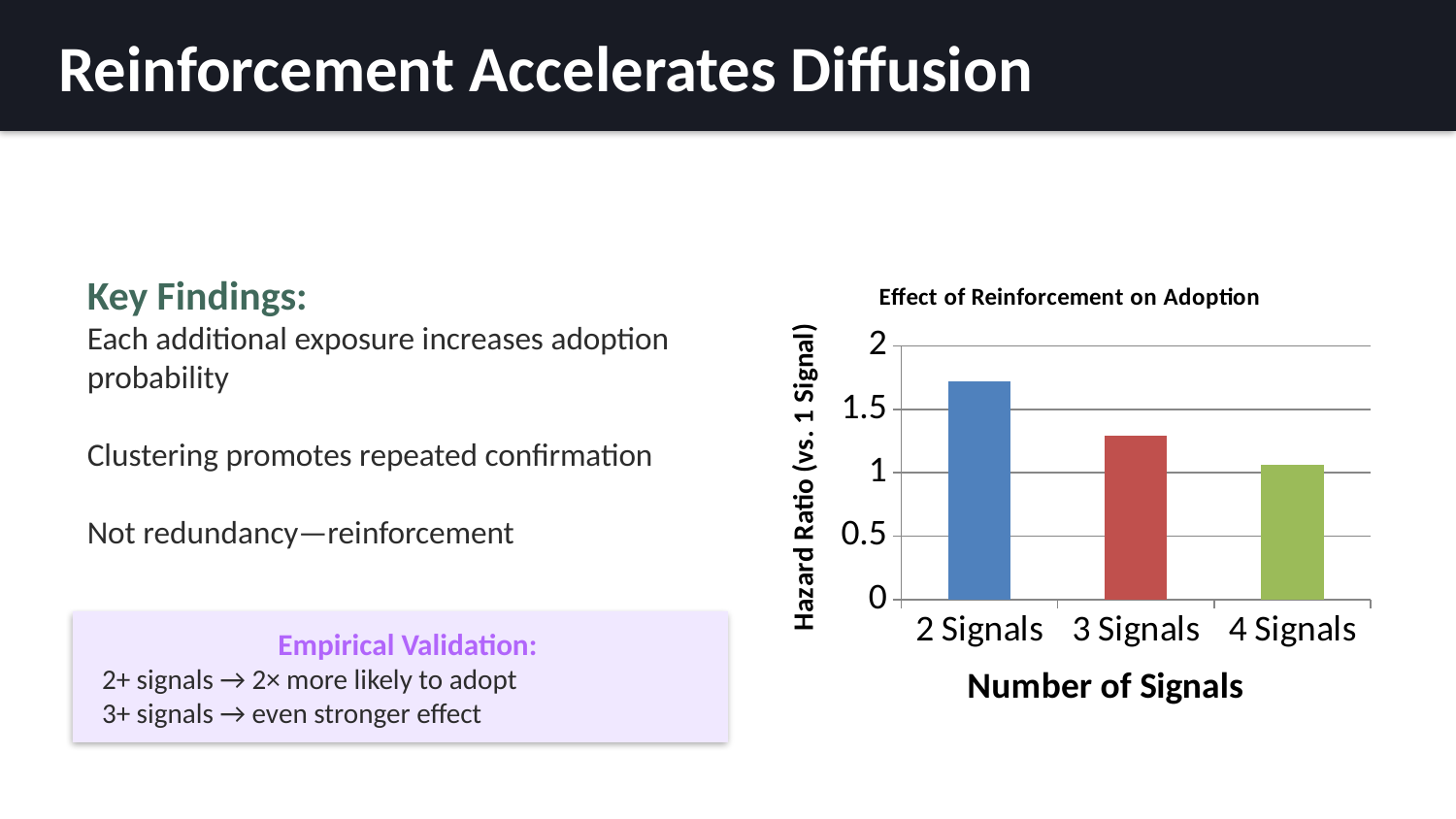
What is the label of the vertical axis of the chart? Hazard Ratio (vs. 1 Signal) What is the title of the chart? Effect of Reinforcement on Adoption Is the value for 3 Signals greater or less than 1.5? less Is the value for 2 Signals greater or less than 1.5? greater What kind of chart is shown on the slide? bar chart Which has a larger hazard ratio, 3 Signals or 4 Signals? 3 Signals Which has a larger hazard ratio, 2 Signals or 3 Signals? 2 Signals Do the hazard ratio values rise or fall as the number of signals increases from 2 to 4? fall How many categories are plotted on the x axis of the chart? 3 Which category has the lowest hazard ratio? 4 Signals Is the value for 4 Signals greater or less than 1.5? less Which category has the highest hazard ratio? 2 Signals